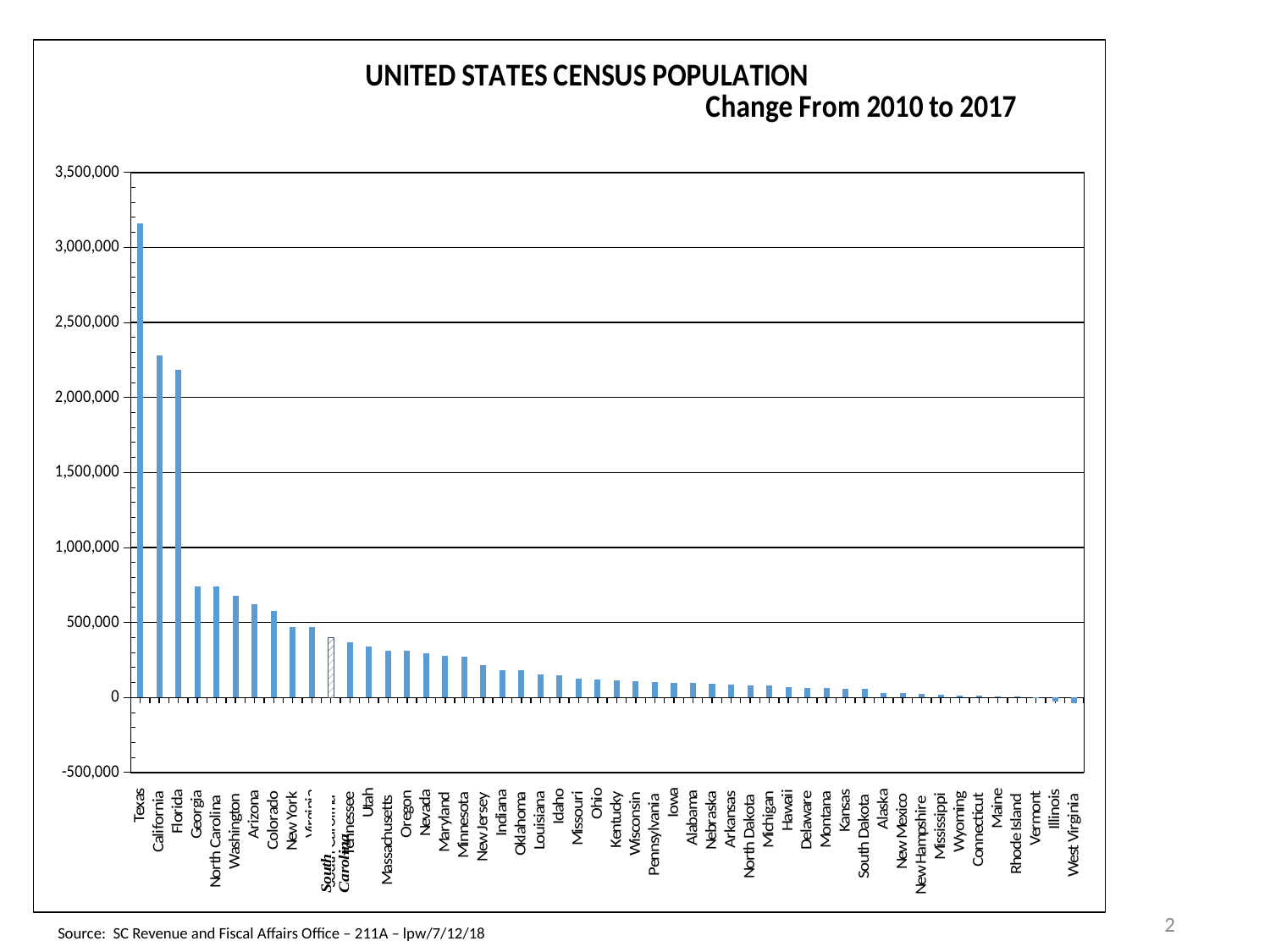
Do the values generally rise or fall moving from left to right along the x axis? Fall Is the value for Florida greater or less than 2,000,000? greater Which state has the largest population change from 2010 to 2017? Texas What kind of chart is shown on the slide? Bar chart What is the title of the chart? UNITED STATES CENSUS POPULATION Change From 2010 to 2017 Is the value for Texas greater or less than 3,000,000? greater Which has a larger population change, California or Florida? California Is the value for Georgia greater or less than 500,000? greater Which state has the lowest population change from 2010 to 2017? West Virginia Which has a larger population change, Georgia or Ohio? Georgia